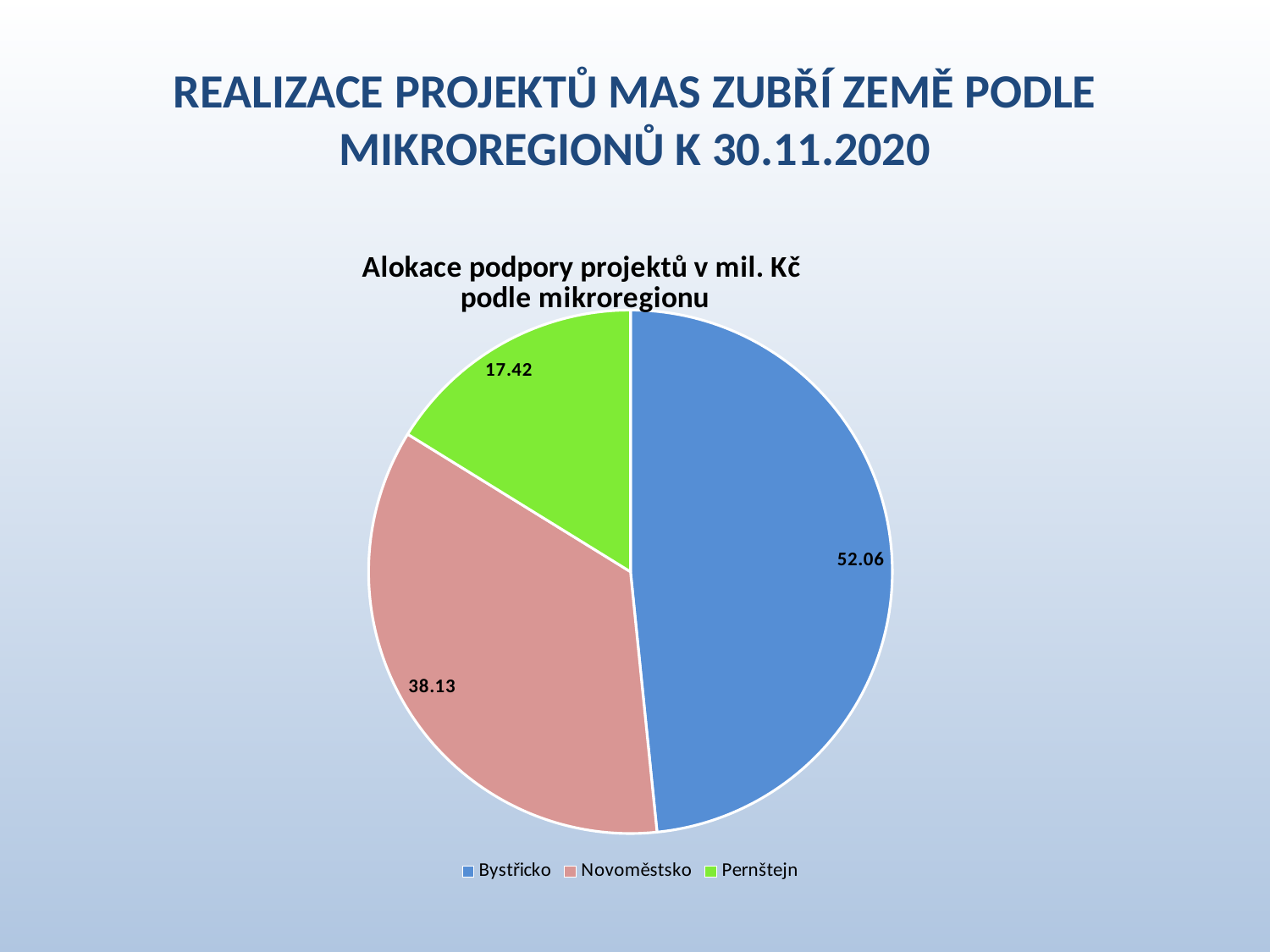
Which microregion has the smallest slice of the pie chart? Pernštejn What is the difference between the values for Bystřicko and Novoměstsko? 13.93 What is the total of all three values shown in the pie chart? 107.61 What is the value for Bystřicko in the pie chart? 52.06 Which is larger, the value for Novoměstsko or the value for Pernštejn? Novoměstsko How many slices does the pie chart have? 3 Which microregion has the largest slice of the pie chart? Bystřicko What is the difference between the values for Novoměstsko and Pernštejn? 20.71 What is the value for Pernštejn in the pie chart? 17.42 What is the value for Novoměstsko in the pie chart? 38.13 What is the title of the chart? Alokace podpory projektů v mil. Kč podle mikroregionu What type of chart is shown on the slide? Pie chart